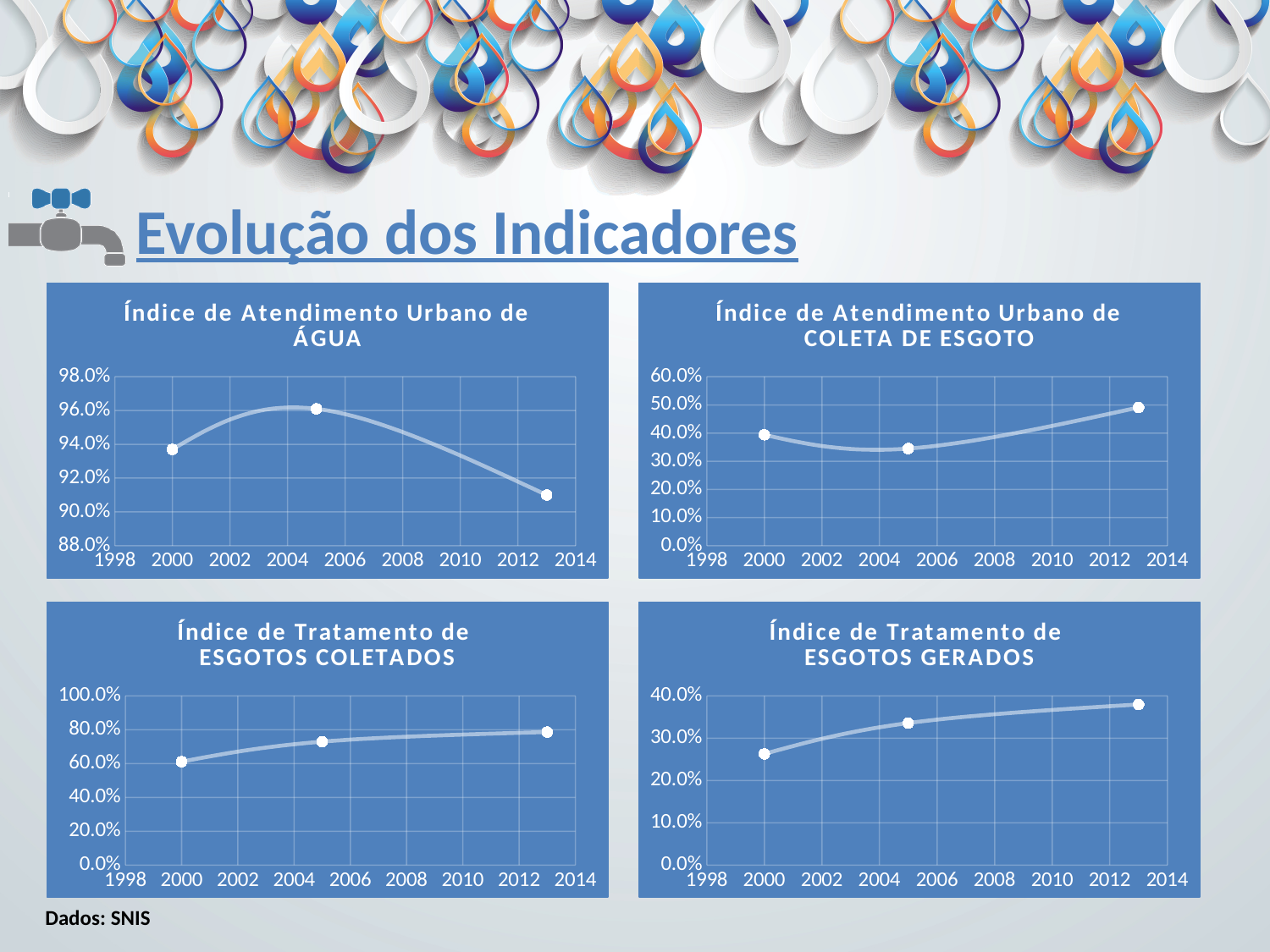
On the 'Índice de Tratamento de ESGOTOS GERADOS' chart, is the value for 2000 greater or less than 20.0%? greater On the 'Índice de Tratamento de ESGOTOS COLETADOS' chart, is the value for 2005 greater or less than 60.0%? greater On the 'Índice de Atendimento Urbano de COLETA DE ESGOTO' chart, which year has the lowest value? 2005 On the 'Índice de Tratamento de ESGOTOS COLETADOS' chart, do the values rise or fall from 2000 to 2013? rise On the 'Índice de Atendimento Urbano de ÁGUA' chart, which year has the highest value? 2005 On the 'Índice de Atendimento Urbano de ÁGUA' chart, which year has the lowest value? 2013 On the 'Índice de Atendimento Urbano de COLETA DE ESGOTO' chart, is the value for 2013 greater or less than 40.0%? greater What kind of chart is the 'Índice de Atendimento Urbano de ÁGUA' chart? line chart How many data points are plotted on the 'Índice de Tratamento de ESGOTOS GERADOS' chart? 3 On the 'Índice de Atendimento Urbano de COLETA DE ESGOTO' chart, which year has the highest value? 2013 On the 'Índice de Tratamento de ESGOTOS GERADOS' chart, which is larger, the value for 2000 or the value for 2013? 2013